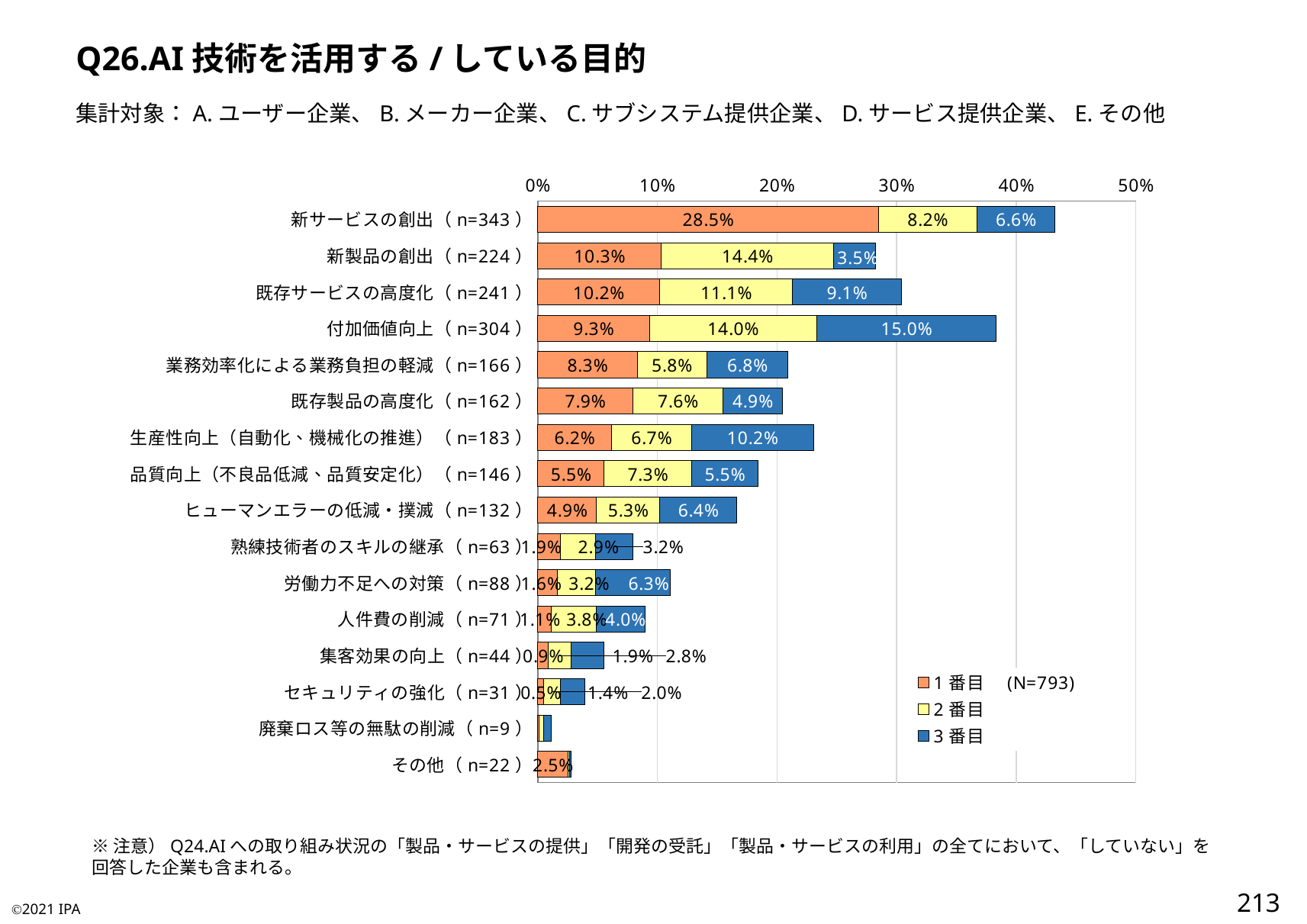
What is the total of the stacked bar for 既存サービスの高度化 (n=241)? 30.4% How many series does the legend list? 3 Which category has the highest 1番目 value? 新サービスの創出 (n=343) What is the 1番目 value for 新サービスの創出 (n=343)? 28.5% Is the total stacked bar for 新サービスの創出 (n=343) greater or less than 40%? greater What kind of chart is shown on the slide? Stacked bar chart What is the 3番目 value for 付加価値向上 (n=304)? 15.0% What is the difference between the 1番目 value for 新サービスの創出 (n=343) and the 1番目 value for 新製品の創出 (n=224)? 18.2% Which is larger: the 3番目 value for 生産性向上（自動化、機械化の推進）(n=183) or the 3番目 value for 既存製品の高度化 (n=162)? 生産性向上（自動化、機械化の推進）(n=183) What is the 2番目 value for 新製品の創出 (n=224)? 14.4% How many categories are plotted on the chart? 16 What N value is shown next to the legend? N=793